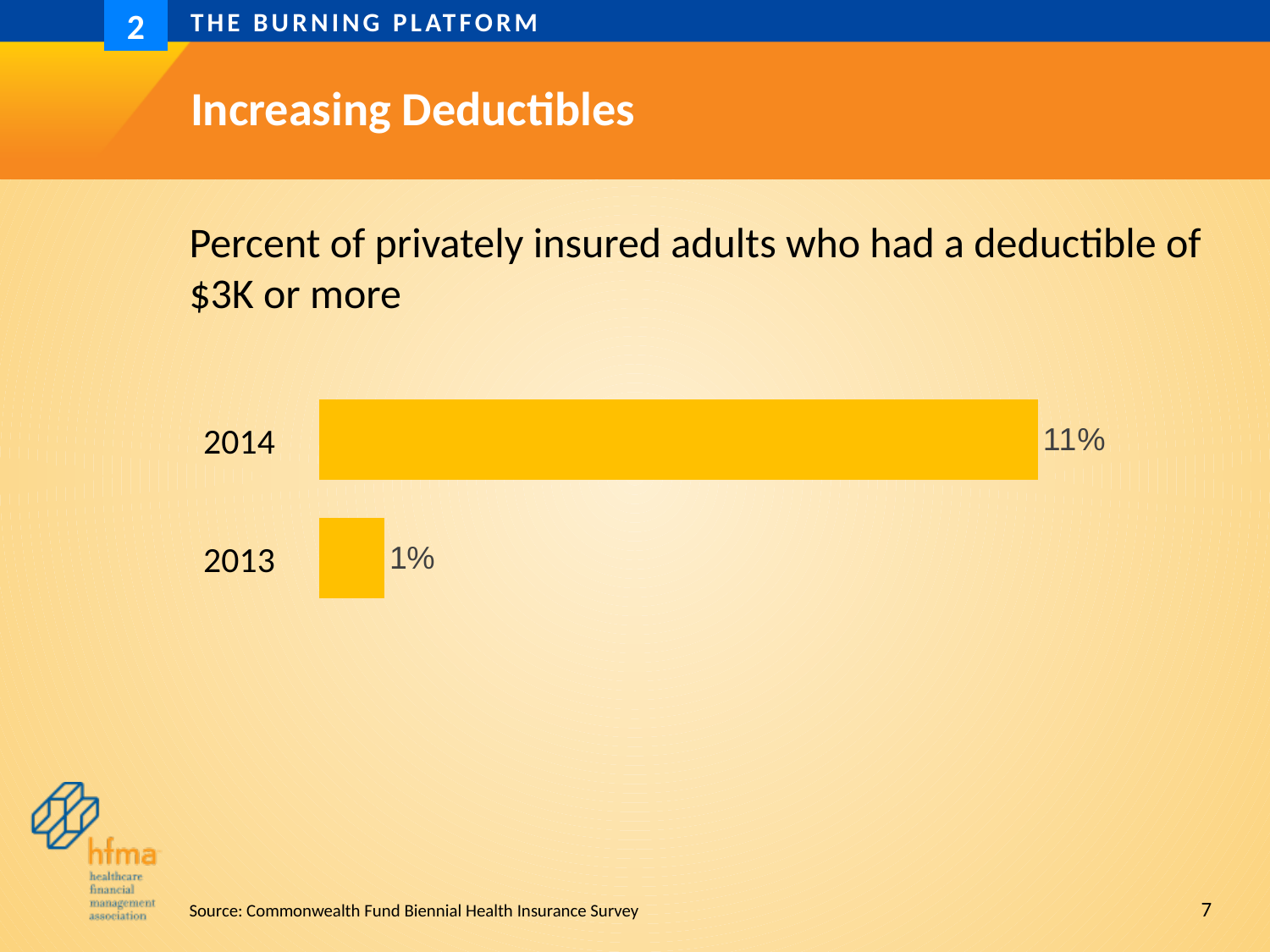
Did the percent of privately insured adults with a deductible of $3K or more rise or fall from 2013 to 2014? rise Which year has the highest value? 2014 What is the difference between the values for 2014 and 2013? 10% Which year has the lowest value? 2013 What is the value for 2014? 11% What is the title of the slide? Increasing Deductibles What kind of chart is shown on the slide? bar chart Which is larger, the value for 2014 or the value for 2013? 2014 What is the source cited for the chart? Commonwealth Fund Biennial Health Insurance Survey What is the value for 2013? 1% How many years are shown in the chart? 2